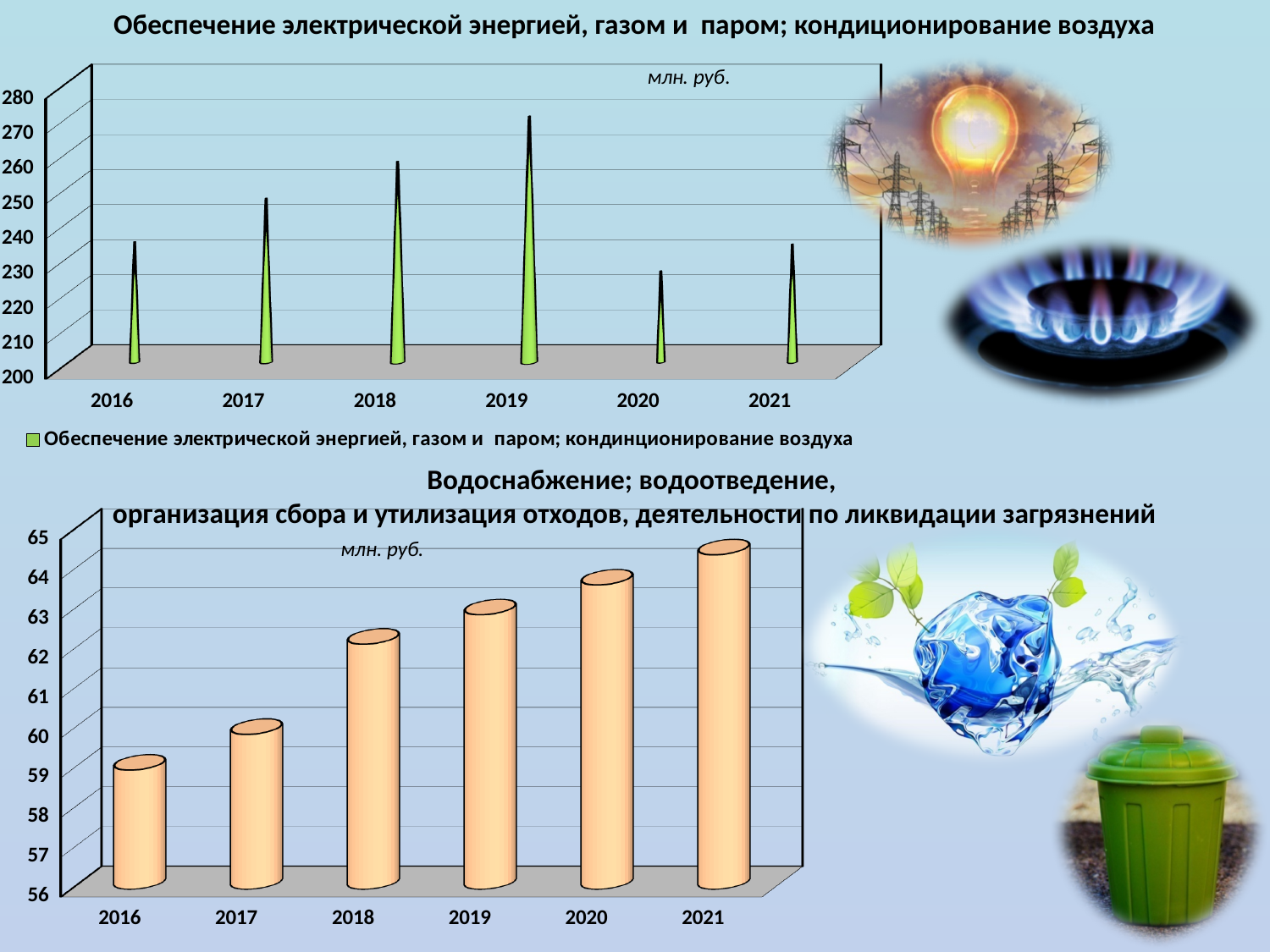
What unit is indicated on the top chart? млн. руб. In the top chart, is the value for 2019 greater or less than 260? greater In the bottom chart, do the values rise or fall from 2016 to 2021? rise In the top chart (Обеспечение электрической энергией, газом и паром; кондиционирование воздуха), which year has the lowest value? 2020 In the bottom chart (Водоснабжение; водоотведение...), which year has the highest value? 2021 In the top chart, is the value for 2020 greater or less than 240? less In the bottom chart (Водоснабжение; водоотведение...), which year has the lowest value? 2016 In the bottom chart, is the value for 2016 greater or less than 60? less What kind of chart is the bottom chart? bar chart In the top chart (Обеспечение электрической энергией, газом и паром; кондиционирование воздуха), which year has the highest value? 2019 How many years are shown on the x axis of the top chart? 6 In the top chart, which is larger, the value for 2017 or the value for 2018? 2018